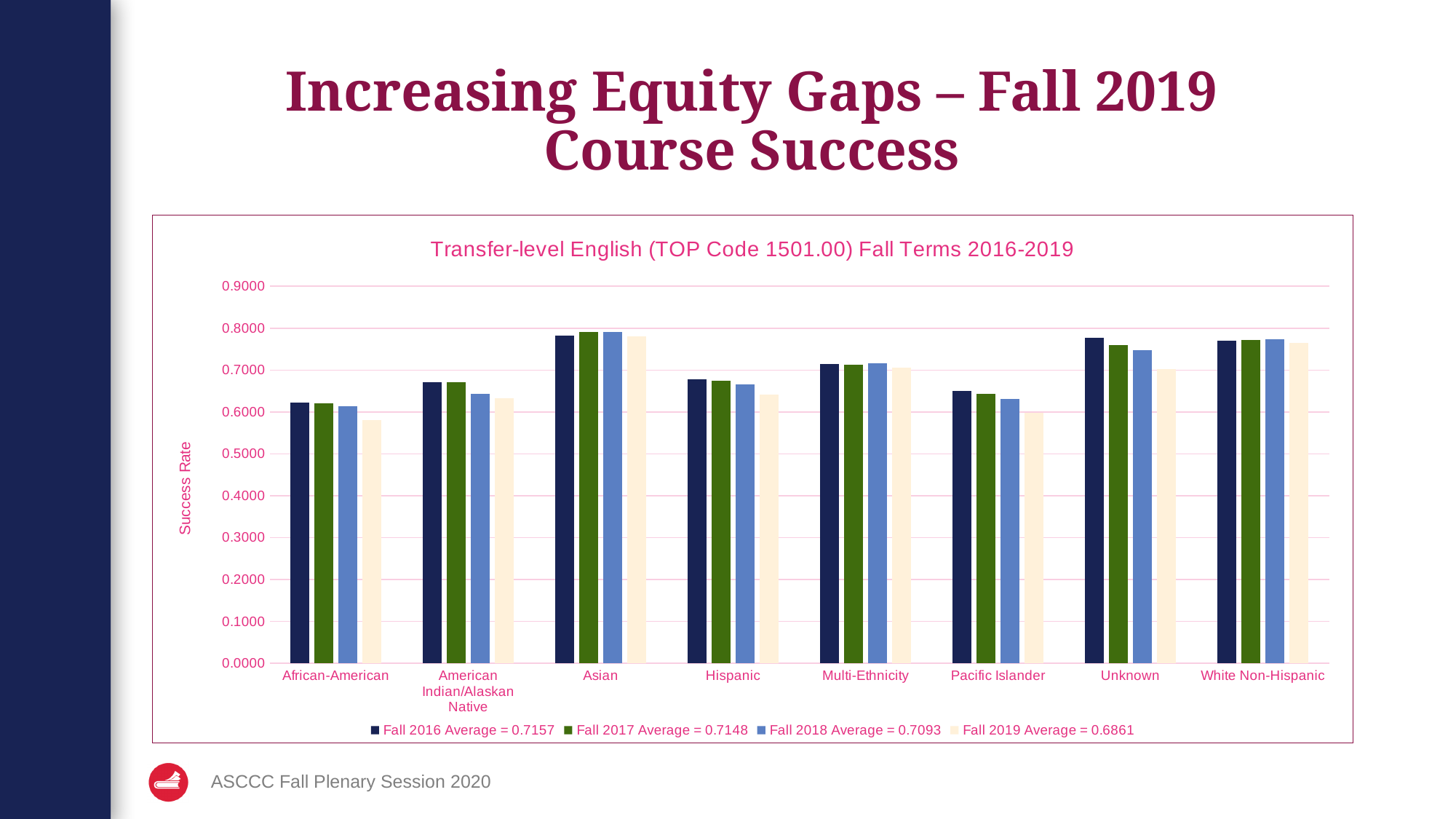
Which category has the highest Fall 2019 success rate? Asian Which is larger for Fall 2016: the success rate for Asian or for African-American? Asian Is the Fall 2017 value for Asian greater or less than 0.7000? greater What kind of chart is shown on the slide? bar chart How many series does the legend list? 4 Do the African-American success rates rise or fall from Fall 2016 to Fall 2019? fall What is the Fall 2016 average success rate given in the legend? 0.7157 Is the Fall 2016 value for Pacific Islander greater or less than 0.6000? greater What is the Fall 2019 average success rate given in the legend? 0.6861 How many ethnicity categories are shown on the x axis? 8 Is the Fall 2019 value for African-American greater or less than 0.6000? less Which category has the lowest Fall 2019 success rate? African-American